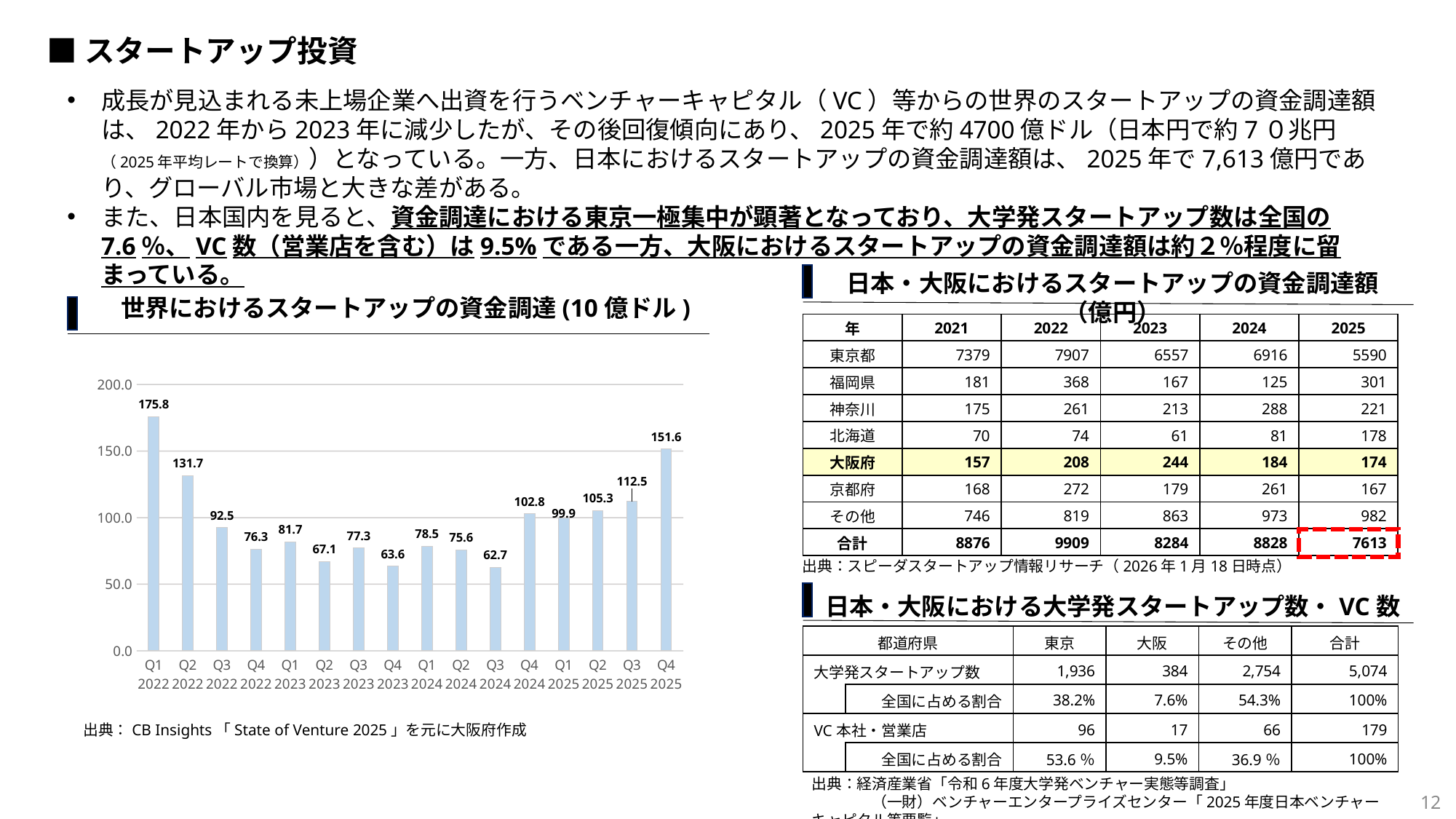
Is the value for Q3 2025 in the world startup funding chart greater or less than 100.0? greater Do the values in the world startup funding chart rise or fall from Q4 2024 to Q4 2025? rise What is the value for Q3 2024 in the world startup funding chart? 62.7 Which quarter has the lowest value in the world startup funding chart? Q3 2024 Which quarter has the highest value in the world startup funding chart? Q1 2022 How many quarters are plotted in the world startup funding chart? 16 Which is larger in the world startup funding chart, Q4 2024 or Q1 2025? Q4 2024 What is the difference between the values for Q1 2022 and Q2 2022 in the world startup funding chart? 44.1 What unit is given in the title of the world startup funding chart? 10億ドル What is the value for Q4 2025 in the world startup funding chart? 151.6 What type of chart is shown on the slide? bar chart What is the value for Q1 2022 in the world startup funding chart? 175.8